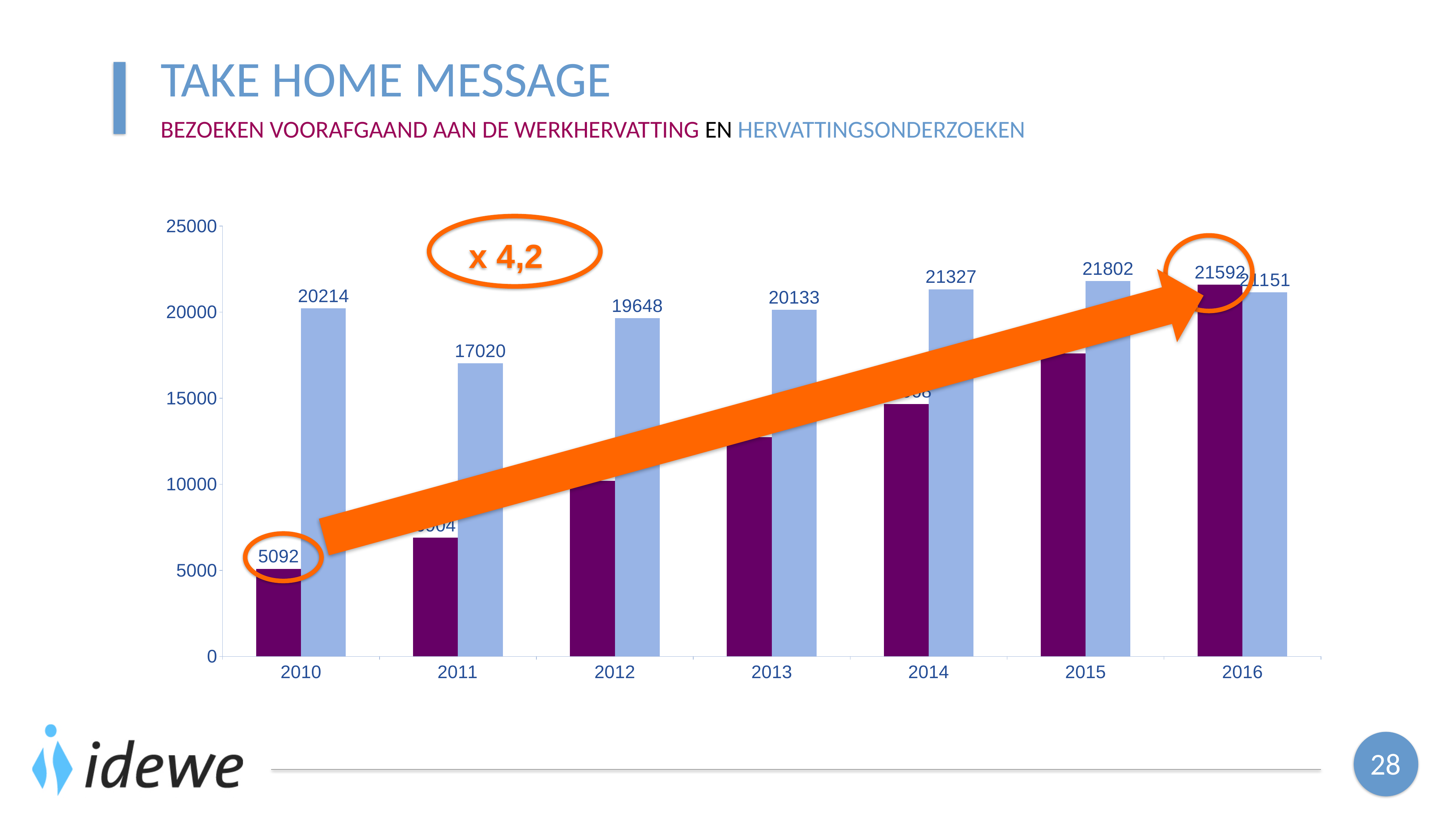
Which is larger in 2016, the purple bar or the light blue bar? the purple bar What is the value of the purple bar for 2010? 5092 What multiplication factor is written in the orange oval annotation on the chart? x 4,2 What is the value of the light blue bar for 2010? 20214 In which year is the light blue bar lowest? 2011 Is the value of the purple bar for 2013 greater or less than 10000? greater How many years are shown on the x axis of the chart? 7 In which year is the light blue bar highest? 2015 What is the value of the light blue bar for 2013? 20133 What is the value of the purple bar for 2016? 21592 What type of chart is shown on the slide? bar chart What is the difference between the light blue bar values for 2015 and 2011? 4782